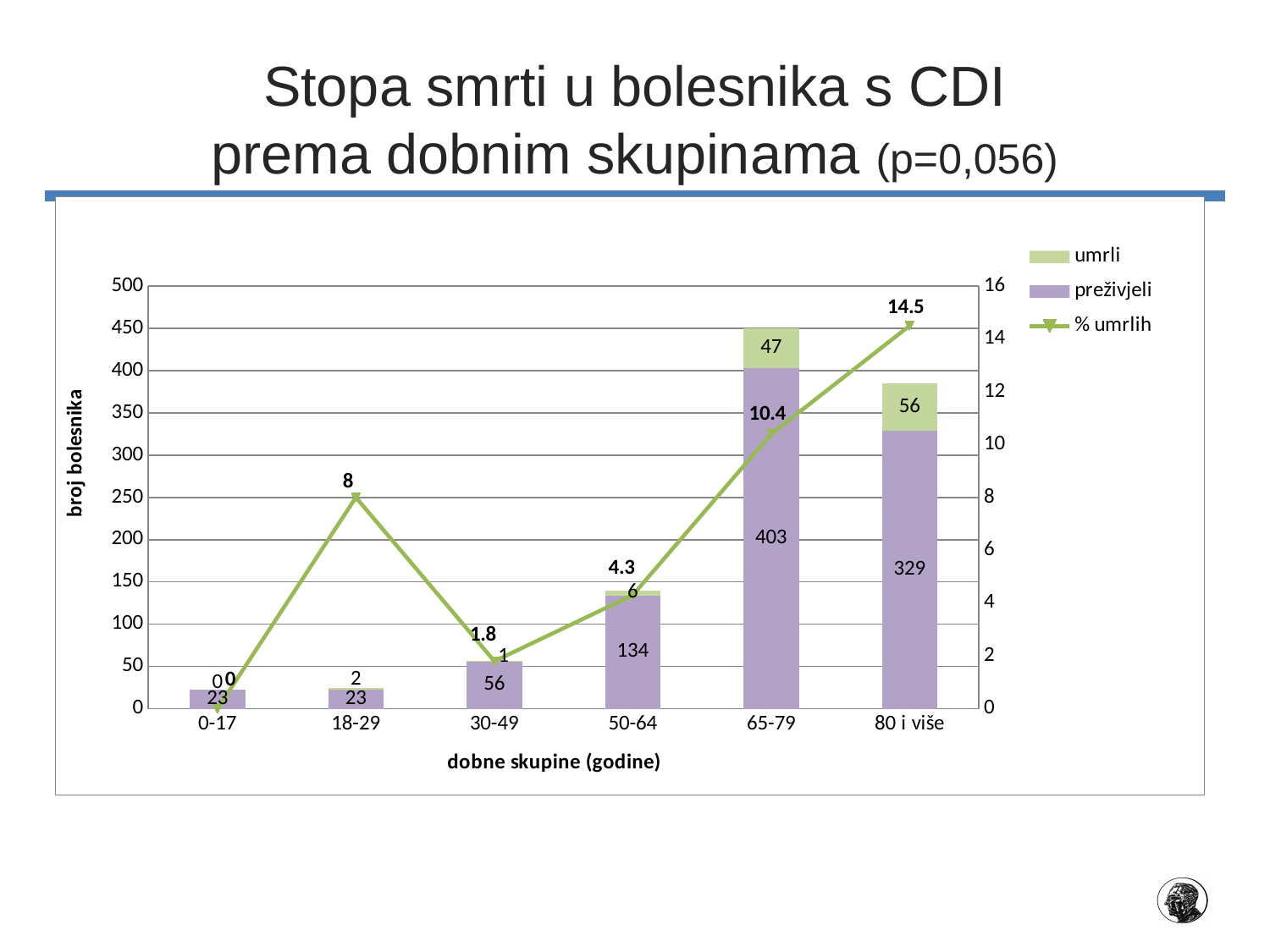
How many series does the legend list? 3 What is the label of the y axis on the left? broj bolesnika Which age group has the lowest number of umrli? 0-17 What is the difference between preživjeli for 65-79 and preživjeli for 80 i više? 74 Which is larger, the umrli value for 65-79 or for 80 i više? 80 i više Does the % umrlih line rise or fall from the 30-49 group to the 80 i više group? rise What is the value of preživjeli for the 65-79 age group? 403 What is the % umrlih value for the 18-29 age group? 8 How many age groups are shown on the x axis? 6 What is the value of umrli for the 80 i više age group? 56 Which age group has the highest % umrlih? 80 i više What is the total of the stacked bar for the 50-64 age group? 140